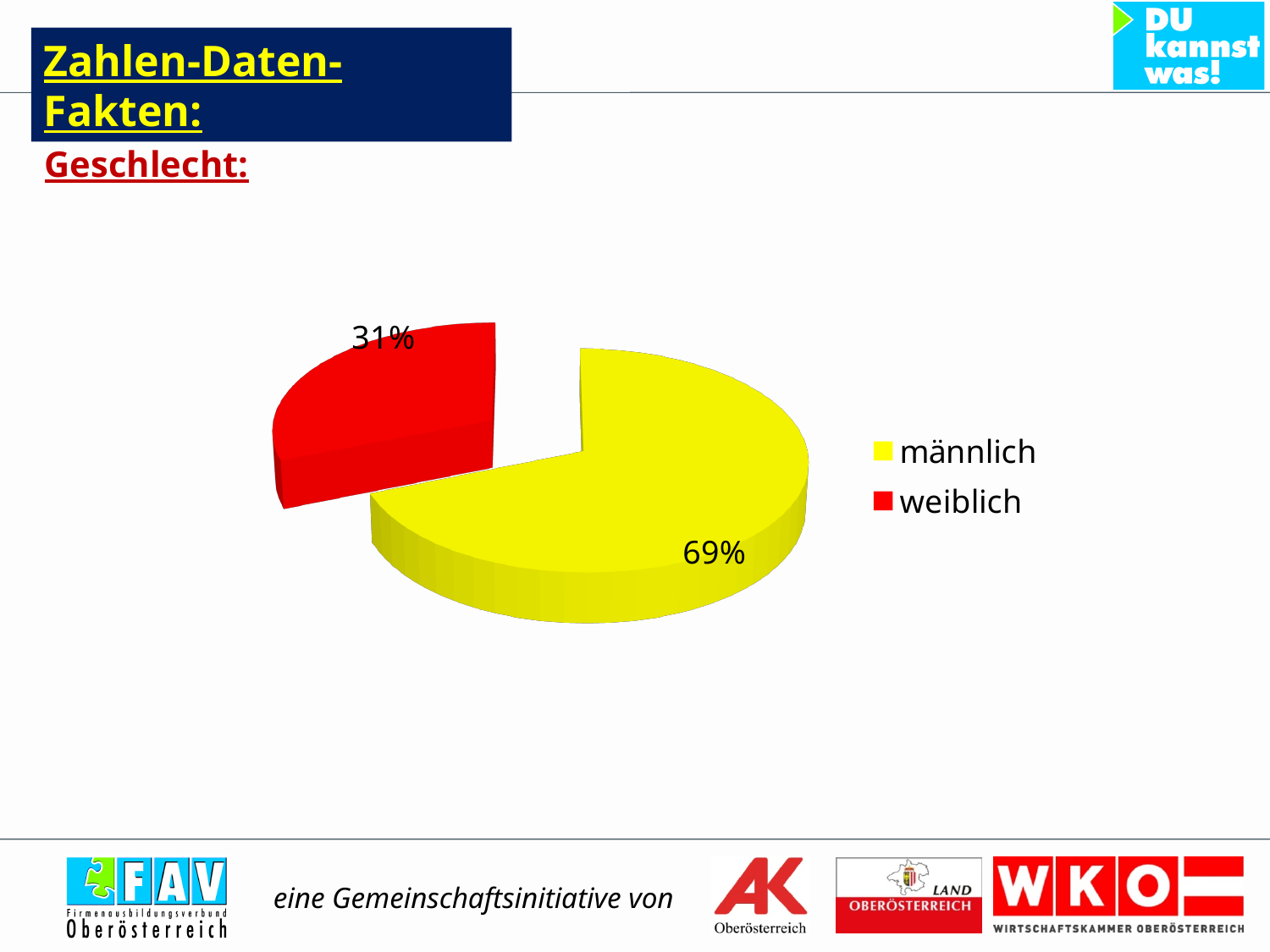
What share of the pie chart is weiblich? 31% Which slice is larger, männlich or weiblich? männlich What share of the pie chart is männlich? 69% How many slices does the pie chart have? 2 What kind of chart is shown on the slide? pie chart What is the difference in percentage points between the männlich and weiblich slices? 38 What colour is the männlich slice? yellow Which category has the largest slice in the pie chart? männlich Which category has the smallest slice in the pie chart? weiblich What colour is the weiblich slice? red How many entries does the legend list? 2